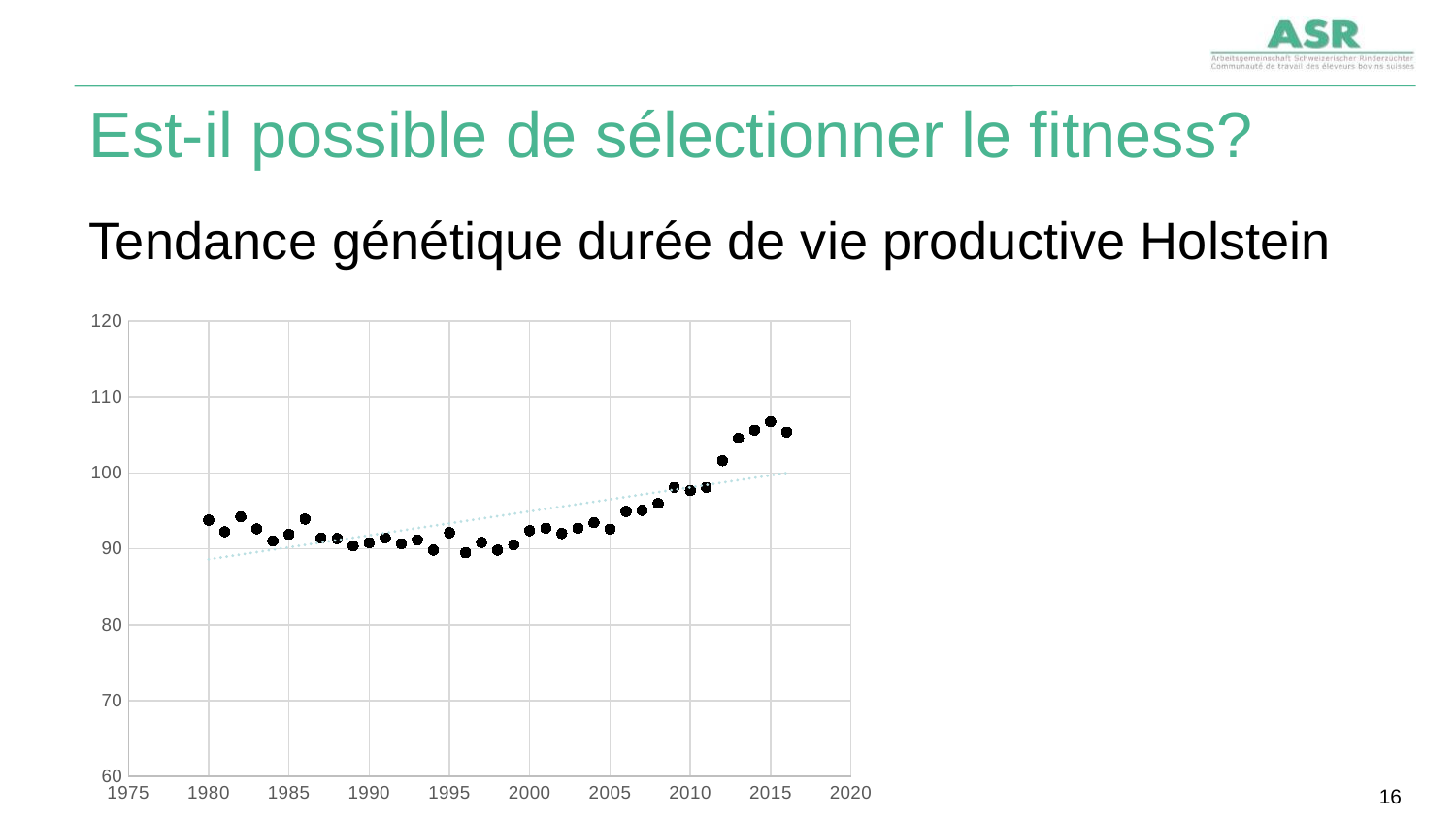
Is the value for 2010 greater or less than 100? less Which is larger, the value for 1980 or the value for 1990? 1980 What is the highest value shown on the y axis of the chart? 120 Overall, do the plotted values rise or fall from 1980 to 2016? rise Is the value for 2015 greater or less than 100? greater Which is larger, the value for 2013 or the value for 1985? 2013 What range of years does the x axis of the chart span? 1975 to 2020 What kind of chart is shown on the slide? scatter chart Is the value for 2005 greater or less than 90? greater